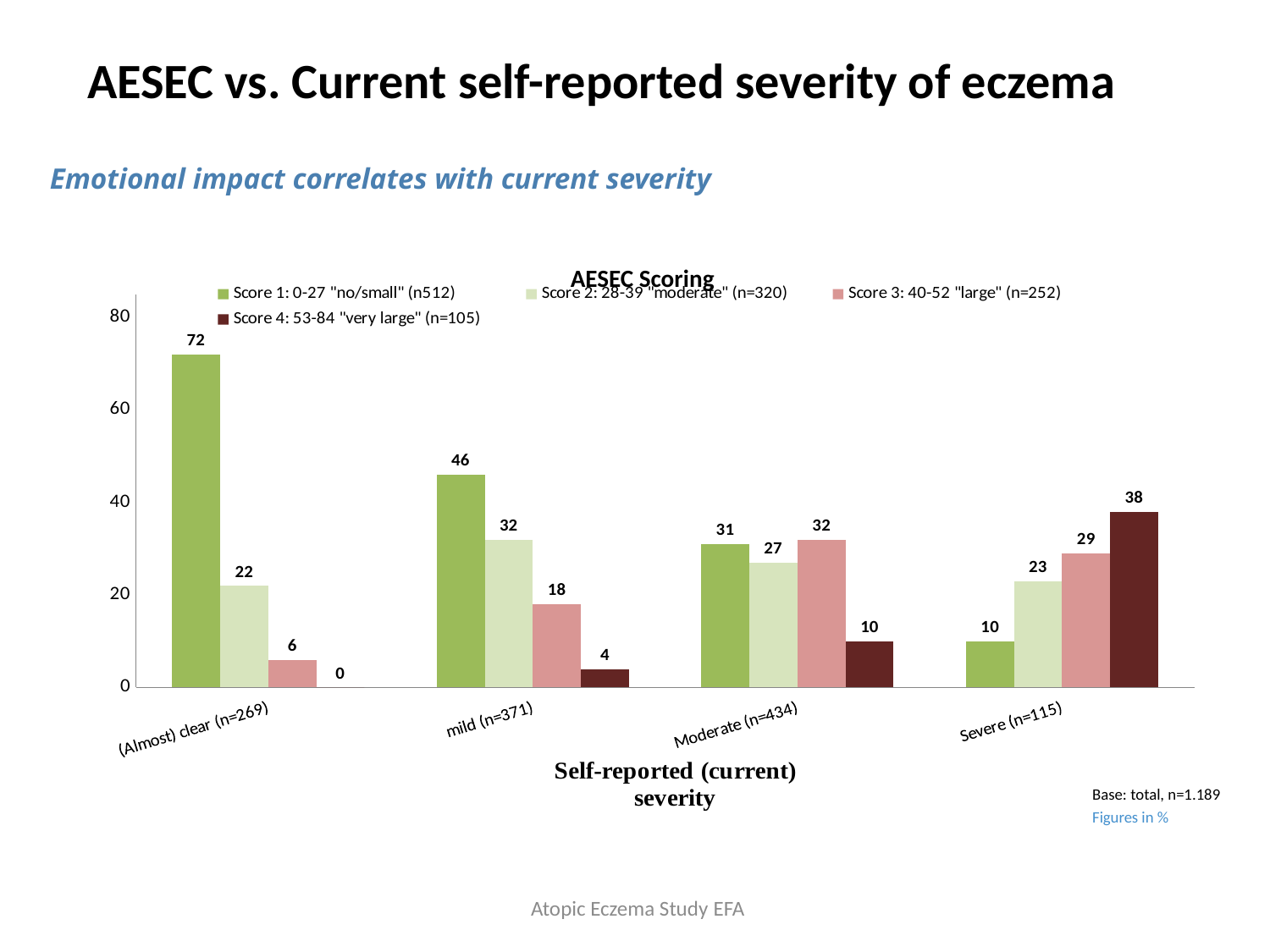
Do the Score 4 values rise or fall as severity increases from (Almost) clear to Severe? rise What is the difference between the Score 1 value for (Almost) clear (n=269) and the Score 1 value for mild (n=371)? 26 How many severity categories are shown on the x axis? 4 What is the value for Score 4 in the Severe (n=115) category? 38 What is the value for Score 1 in the (Almost) clear (n=269) category? 72 Which is larger in the Severe (n=115) category: Score 3 or Score 4? Score 4 What is the value for Score 3 in the Moderate (n=434) category? 32 In which severity category is the Score 1 value highest? (Almost) clear (n=269) In which severity category is the Score 4 value lowest? (Almost) clear (n=269) What is the value for Score 2 in the mild (n=371) category? 32 How many series does the legend list? 4 What type of chart is shown on the slide? bar chart